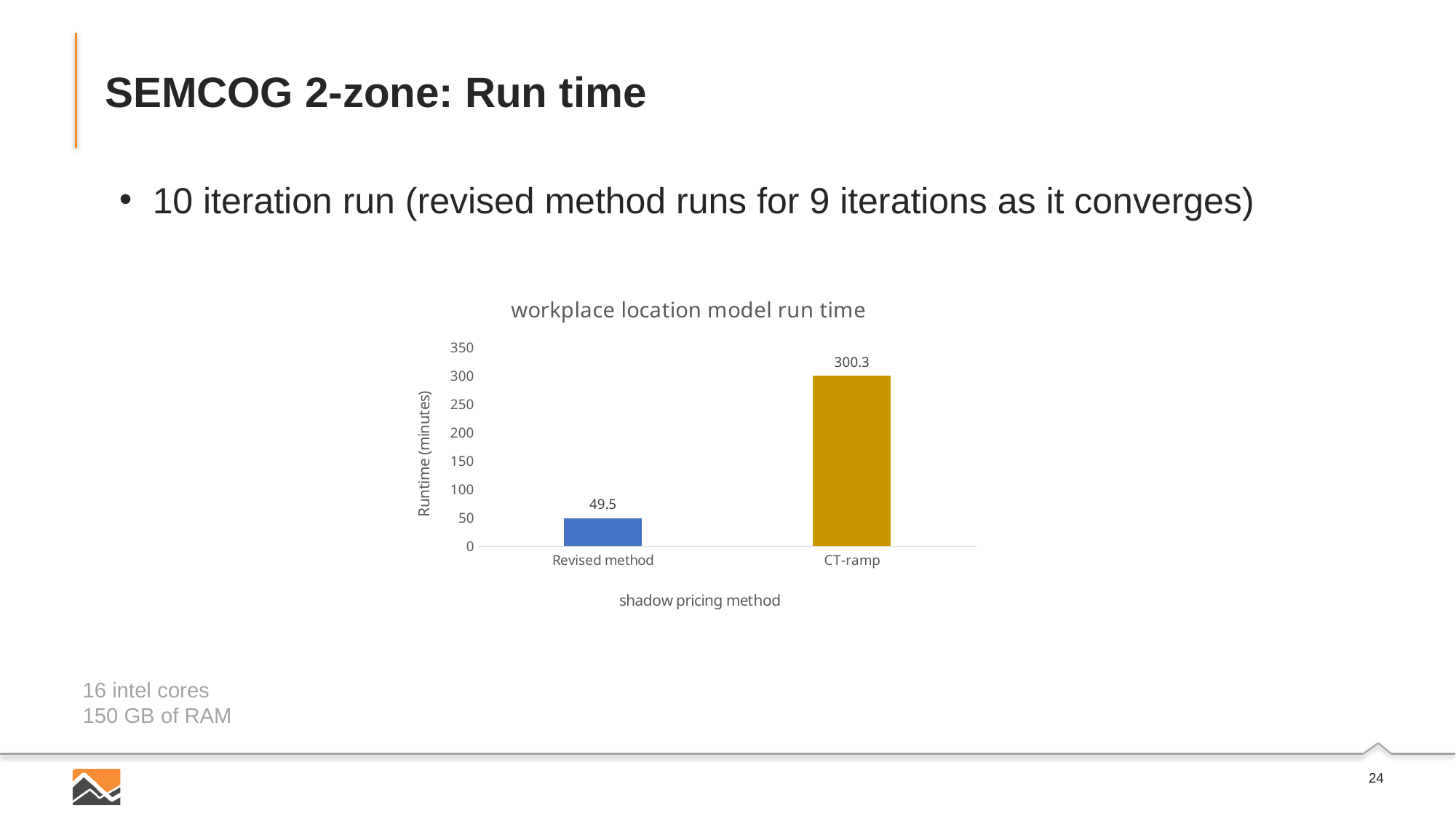
What is the label of the vertical axis? Runtime (minutes) What is the title of the chart? workplace location model run time What is the difference in runtime between CT-ramp and the Revised method? 250.8 What is the runtime for CT-ramp? 300.3 Which has a larger runtime, the Revised method or CT-ramp? CT-ramp Is the runtime for the Revised method greater or less than 100? less What is the runtime for the Revised method? 49.5 How many shadow pricing methods are shown in the chart? 2 Which shadow pricing method has the highest runtime? CT-ramp Which shadow pricing method has the lowest runtime? Revised method Is the runtime for CT-ramp greater or less than 250? greater What kind of chart is shown on the slide? Bar chart